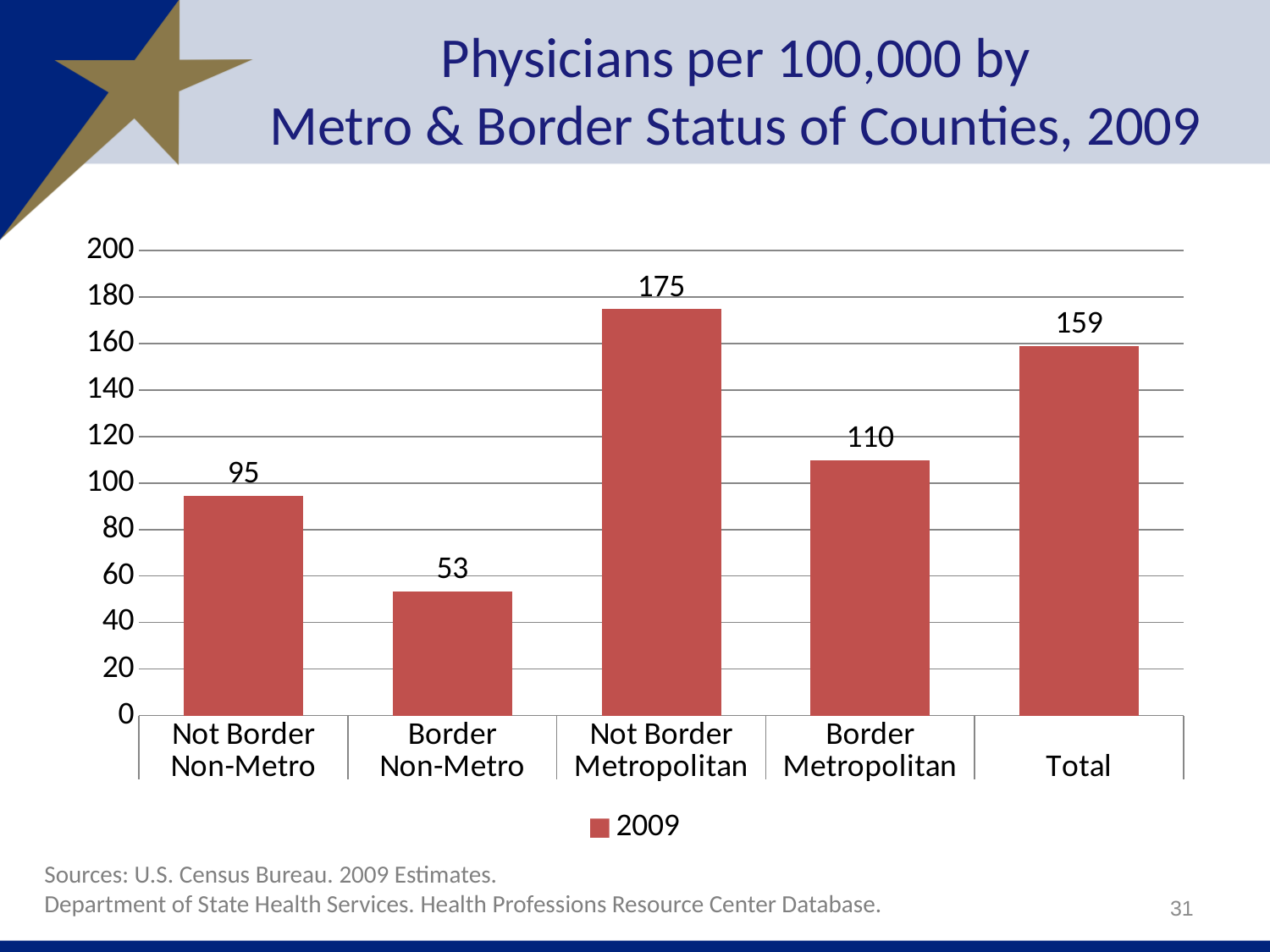
What is the Total value shown on the chart? 159 How many categories are shown on the x axis? 5 What is the value for Not Border Metropolitan counties? 175 What is the value for Not Border Non-Metro counties? 95 Which category has the highest number of physicians per 100,000? Not Border Metropolitan Which category has the lowest number of physicians per 100,000? Border Non-Metro What series does the legend list? 2009 Which is larger, the value for Not Border Non-Metro or Border Non-Metro? Not Border Non-Metro What kind of chart is shown on the slide? Bar chart What is the difference between the Not Border Metropolitan and Border Metropolitan values? 65 What is the value for Border Metropolitan counties? 110 What is the value for Border Non-Metro counties? 53